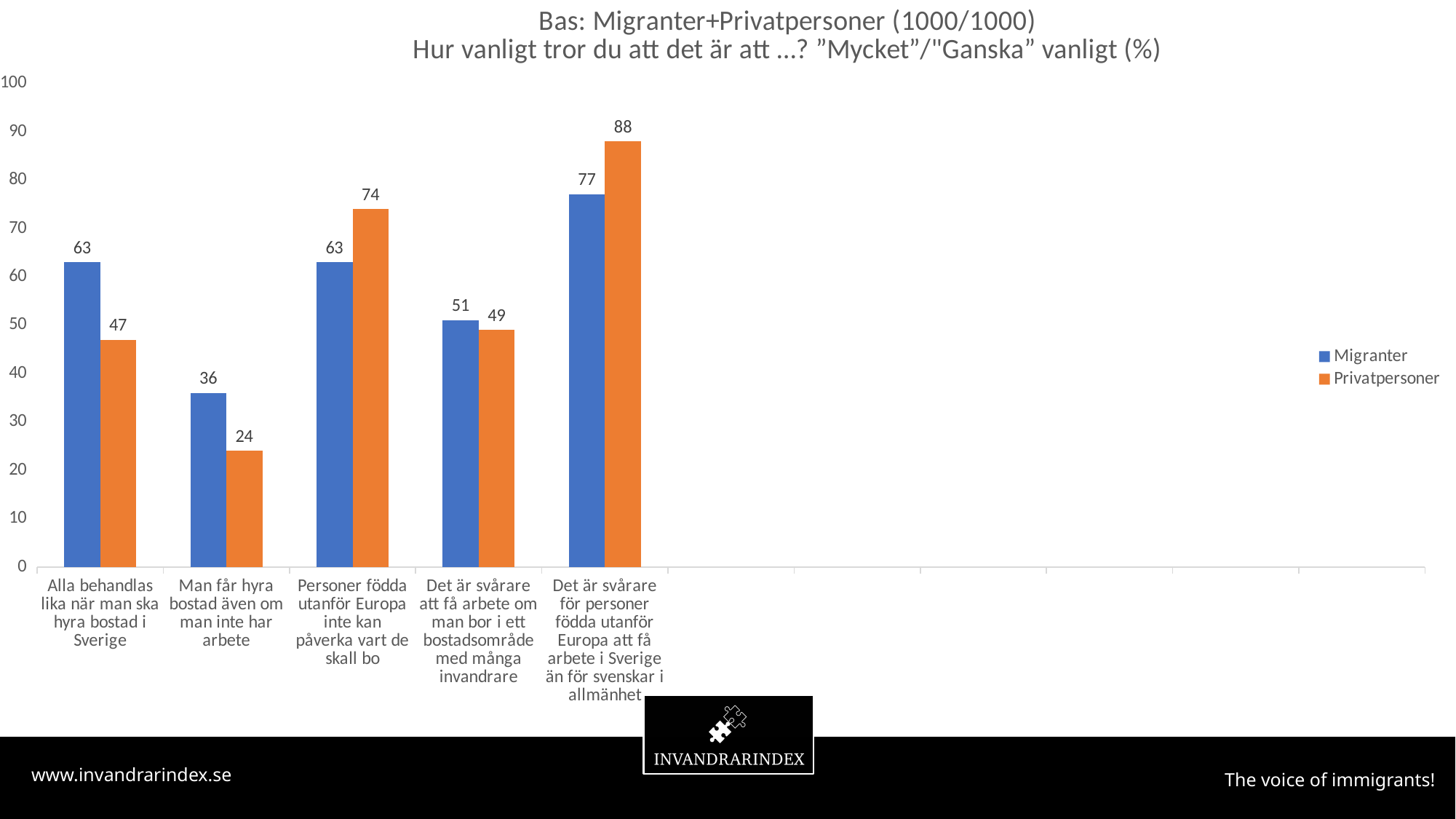
What is the difference between the Privatpersoner and Migranter values for "Det är svårare för personer födda utanför Europa att få arbete i Sverige än för svenskar i allmänhet"? 11 Which category has the lowest Migranter value? Man får hyra bostad även om man inte har arbete How many categories are shown on the x axis? 5 What is the difference between the Migranter and Privatpersoner values for "Alla behandlas lika när man ska hyra bostad i Sverige"? 16 How many series does the legend list? 2 Which colour represents the Privatpersoner series? Orange What is the Migranter value for "Man får hyra bostad även om man inte har arbete"? 36 For "Man får hyra bostad även om man inte har arbete", which series has the larger value, Migranter or Privatpersoner? Migranter Which category has the highest Privatpersoner value? Det är svårare för personer födda utanför Europa att få arbete i Sverige än för svenskar i allmänhet What is the Privatpersoner value for "Alla behandlas lika när man ska hyra bostad i Sverige"? 47 What is the Privatpersoner value for "Personer födda utanför Europa inte kan påverka vart de skall bo"? 74 What kind of chart is shown on the slide? Bar chart